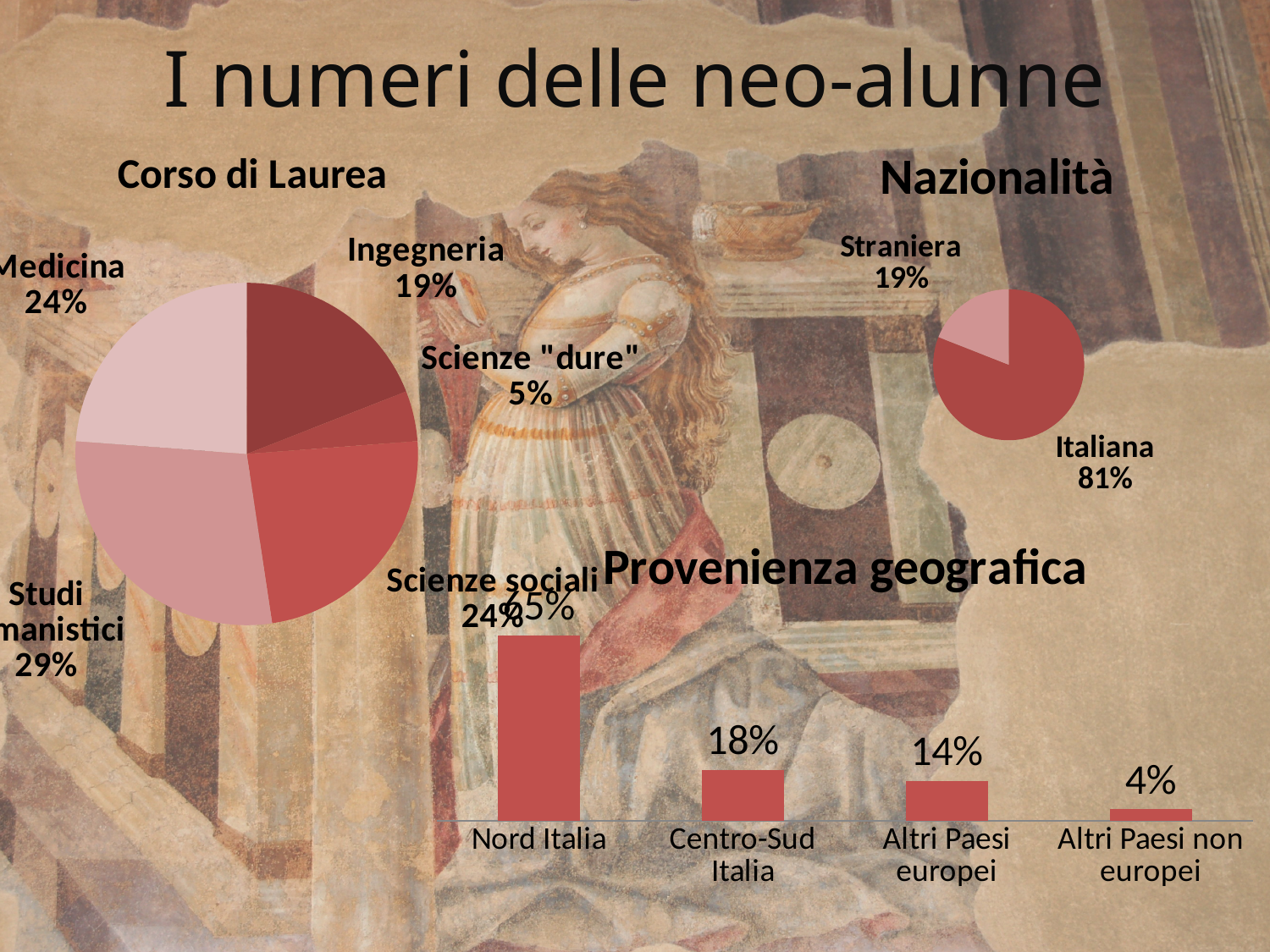
In the Nazionalità pie chart, what share is Italiana? 81% What kind of chart is the Provenienza geografica chart? Bar chart In the Corso di Laurea pie chart, which category has the smallest share? Scienze "dure" In the Nazionalità pie chart, what share is Straniera? 19% In the Corso di Laurea pie chart, what is the difference between Medicina and Scienze "dure"? 19% In the Provenienza geografica bar chart, which category has the lowest value? Altri Paesi non europei In the Corso di Laurea pie chart, what share is Medicina? 24% In the Provenienza geografica bar chart, what is the value for Altri Paesi non europei? 4% In the Provenienza geografica bar chart, what is the difference between Centro-Sud Italia and Altri Paesi europei? 4% In the Provenienza geografica bar chart, what is the value for Nord Italia? 65% How many categories does the Provenienza geografica bar chart show? 4 In the Corso di Laurea pie chart, what share is Ingegneria? 19%